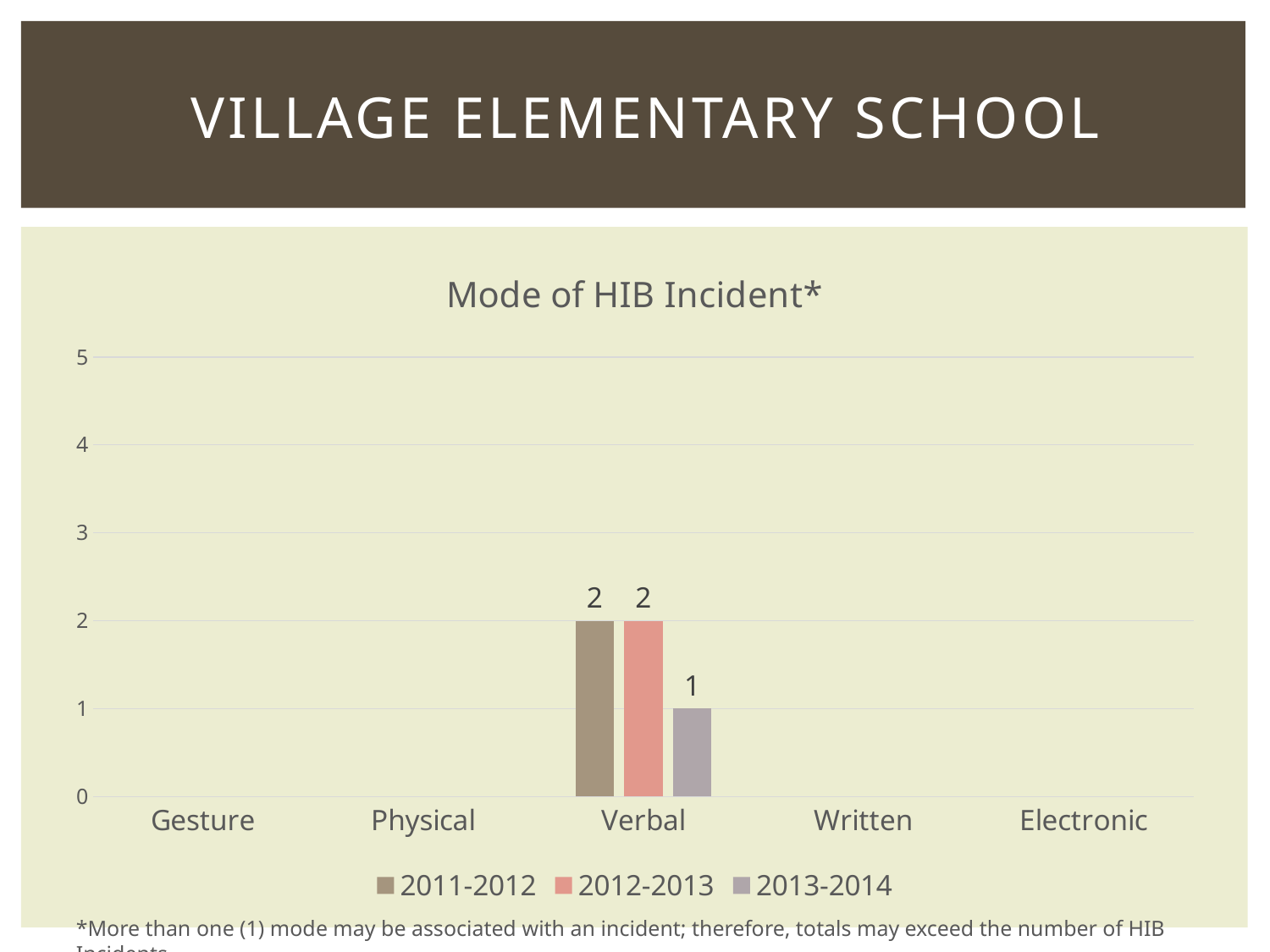
What is the difference between the Verbal values for 2011-2012 and 2013-2014? 1 What is the value for Verbal in the 2011-2012 series? 2 Is the value for Verbal in 2011-2012 greater or less than 3? less How many categories are shown on the x axis? 5 What kind of chart is shown on the slide? bar chart What is the title of the chart? Mode of HIB Incident* How many series does the legend list? 3 Which category has the highest values in the chart? Verbal What is the value for Verbal in the 2012-2013 series? 2 What is the value for Verbal in the 2013-2014 series? 1 Which is larger for Verbal: the 2012-2013 value or the 2013-2014 value? 2012-2013